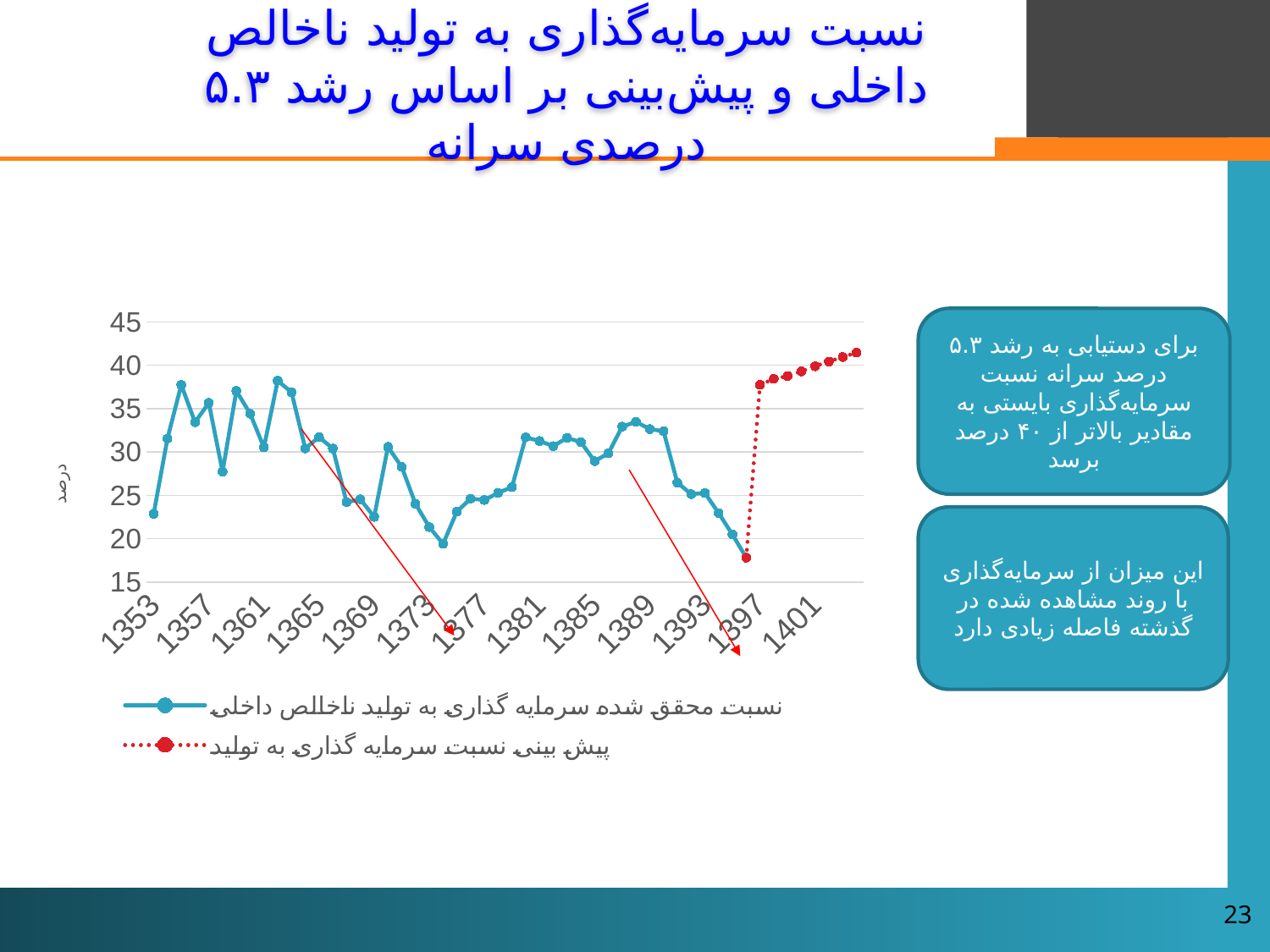
What kind of chart is shown on the slide? line chart Does the realized investment ratio rise or fall between 1389 and 1397? fall Is the realized investment ratio for 1355 greater or less than 35? greater Which year has the lowest value in the realized investment ratio series? 1396 How many series does the legend list? 2 What is the highest value shown on the y axis? 45 Is the realized investment ratio for 1353 greater or less than 25? less Which is larger: the realized investment ratio in 1355 or in 1353? 1355 Does the forecast (red dotted) series rise or fall from 1397 onward? rise Is the last point of the forecast (red dotted) series greater or less than 40? greater What is the first year shown on the x axis? 1353